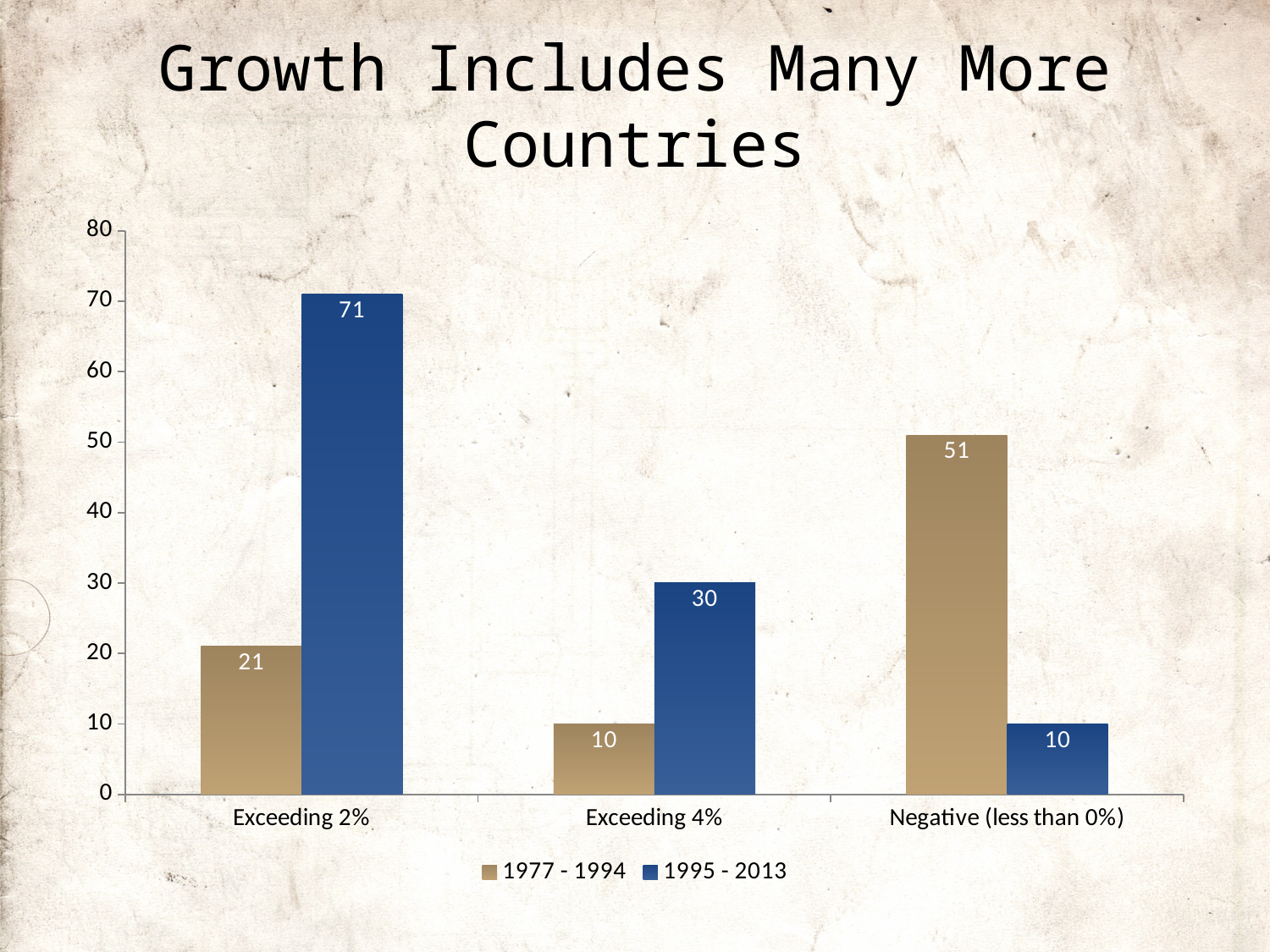
What is the title of the slide? Growth Includes Many More Countries What is the value for 1995 - 2013 in the Exceeding 2% category? 71 Is the value for 1995 - 2013 in the Exceeding 4% category greater or less than 20? greater How many categories are shown on the x axis? 3 In the Negative (less than 0%) category, which series has the larger value, 1977 - 1994 or 1995 - 2013? 1977 - 1994 What is the value for 1977 - 1994 in the Negative (less than 0%) category? 51 What kind of chart is shown on the slide? bar chart How many series does the legend list? 2 Which category has the highest value for the 1995 - 2013 series? Exceeding 2% What is the value for 1977 - 1994 in the Exceeding 4% category? 10 Which category has the lowest value for the 1977 - 1994 series? Exceeding 4% What is the difference between the 1995 - 2013 and 1977 - 1994 values in the Exceeding 2% category? 50